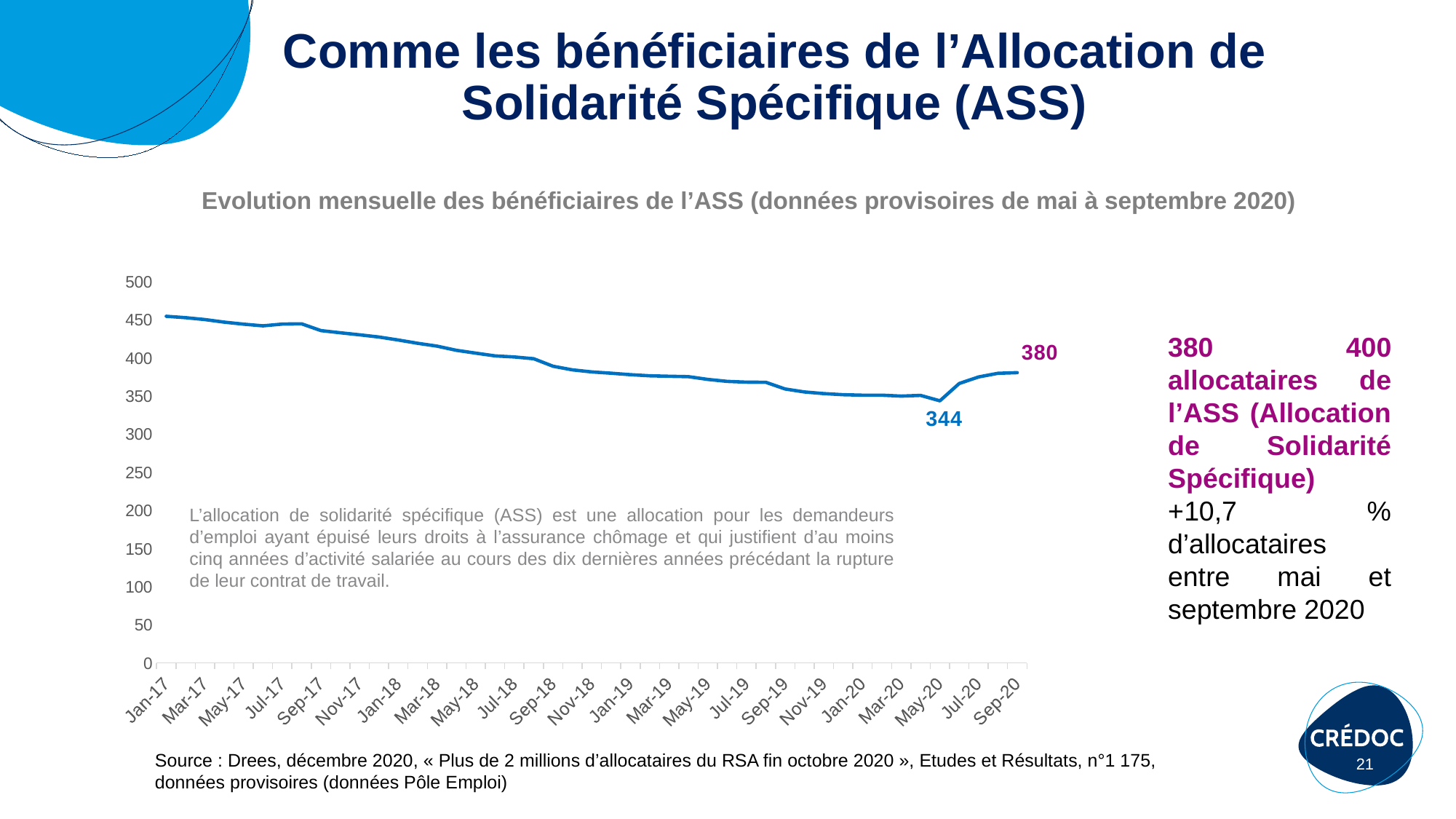
What is the difference between the values labelled for Sep-20 and May-20? 36 Is the value for Jan-20 greater or less than 400? less At which month does the line reach its lowest point? May-20 Do the values rise or fall along the x axis from Jan-17 to May-20? fall What is the value of ASS beneficiaries shown for Sep-20? 380 At which month does the line reach its highest point? Jan-17 What is the title of the chart? Evolution mensuelle des bénéficiaires de l'ASS (données provisoires de mai à septembre 2020) Is the value for Jan-17 greater or less than 400? greater What type of chart is shown on the slide? line chart What is the value of ASS beneficiaries shown for May-20? 344 Is the value for Jan-18 greater or less than 400? greater Which is larger, the value for Sep-20 or the value for May-20? Sep-20